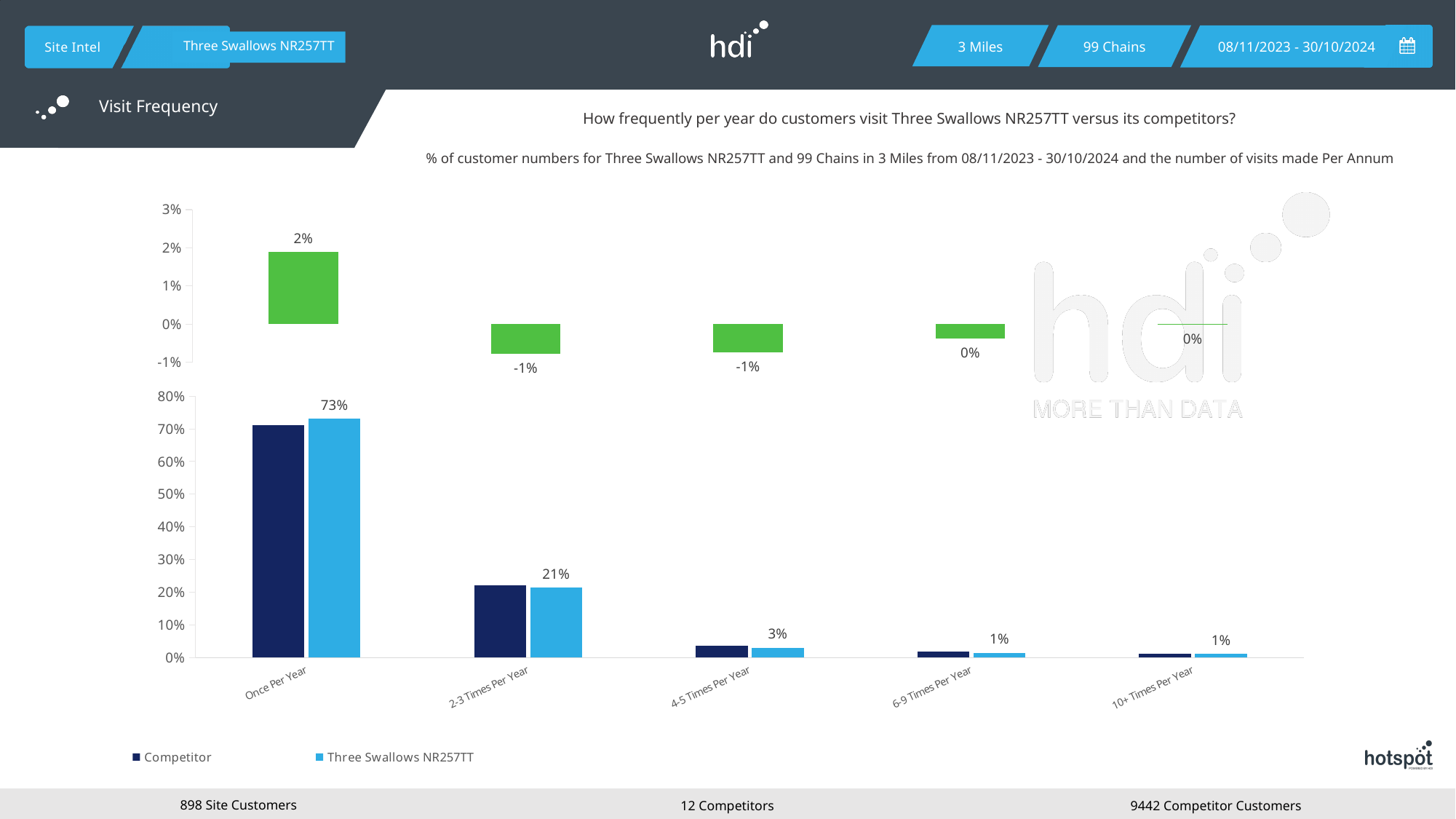
In the bottom chart, is the Competitor value for 2-3 Times Per Year greater or less than 30%? less What kind of chart is the bottom chart? bar chart How many series does the legend of the bottom chart list? 2 In the bottom chart, do the Three Swallows NR257TT values rise or fall moving from Once Per Year to 10+ Times Per Year? fall In the bottom chart, is the Competitor value for Once Per Year greater or less than 60%? greater In the bottom chart, what is the difference between the Three Swallows NR257TT values for Once Per Year and 2-3 Times Per Year? 52% In the bottom chart, which category has the highest value for Three Swallows NR257TT? Once Per Year In the top green chart, what is the value shown for 2-3 Times Per Year? -1% In the bottom chart, what is the value for Three Swallows NR257TT in the 2-3 Times Per Year category? 21% In the bottom chart, what is the value for Three Swallows NR257TT in the Once Per Year category? 73% In the top green chart, what is the value shown for Once Per Year? 2% How many visit frequency categories are shown on the x axis of the bottom chart? 5